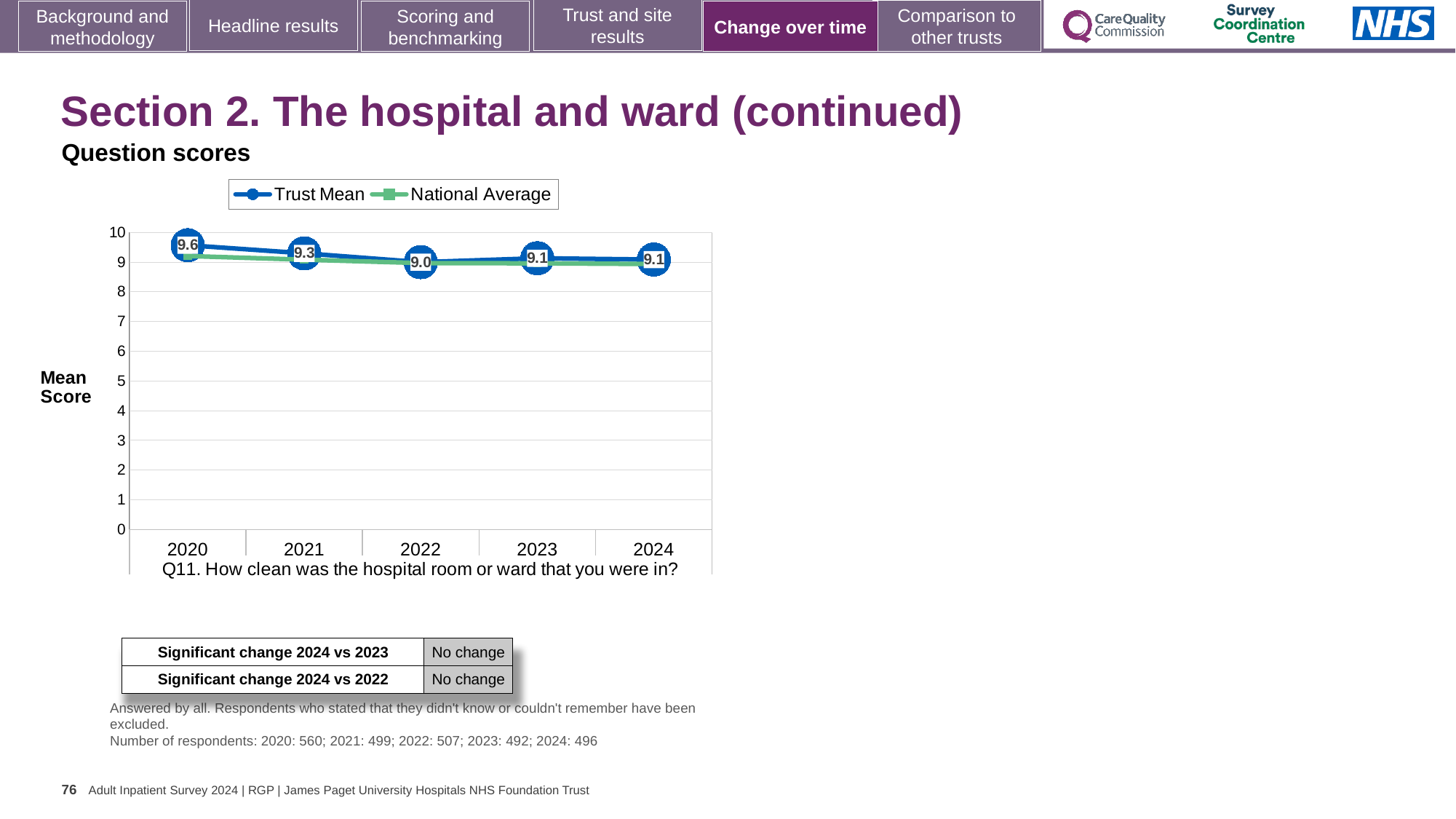
What kind of chart is shown on the slide? line chart How many series does the legend list? 2 Does the Trust Mean rise or fall from 2020 to 2022? fall In which year is the Trust Mean highest? 2020 In which year is the Trust Mean lowest? 2022 What is the Trust Mean value for 2022? 9.0 What is the Trust Mean value for 2024? 9.1 What is the difference between the Trust Mean in 2020 and in 2022? 0.6 What is the Trust Mean value for 2020? 9.6 Which year has the larger Trust Mean, 2020 or 2021? 2020 Is the National Average value for 2020 greater or less than 5? greater How many years are shown on the x axis? 5